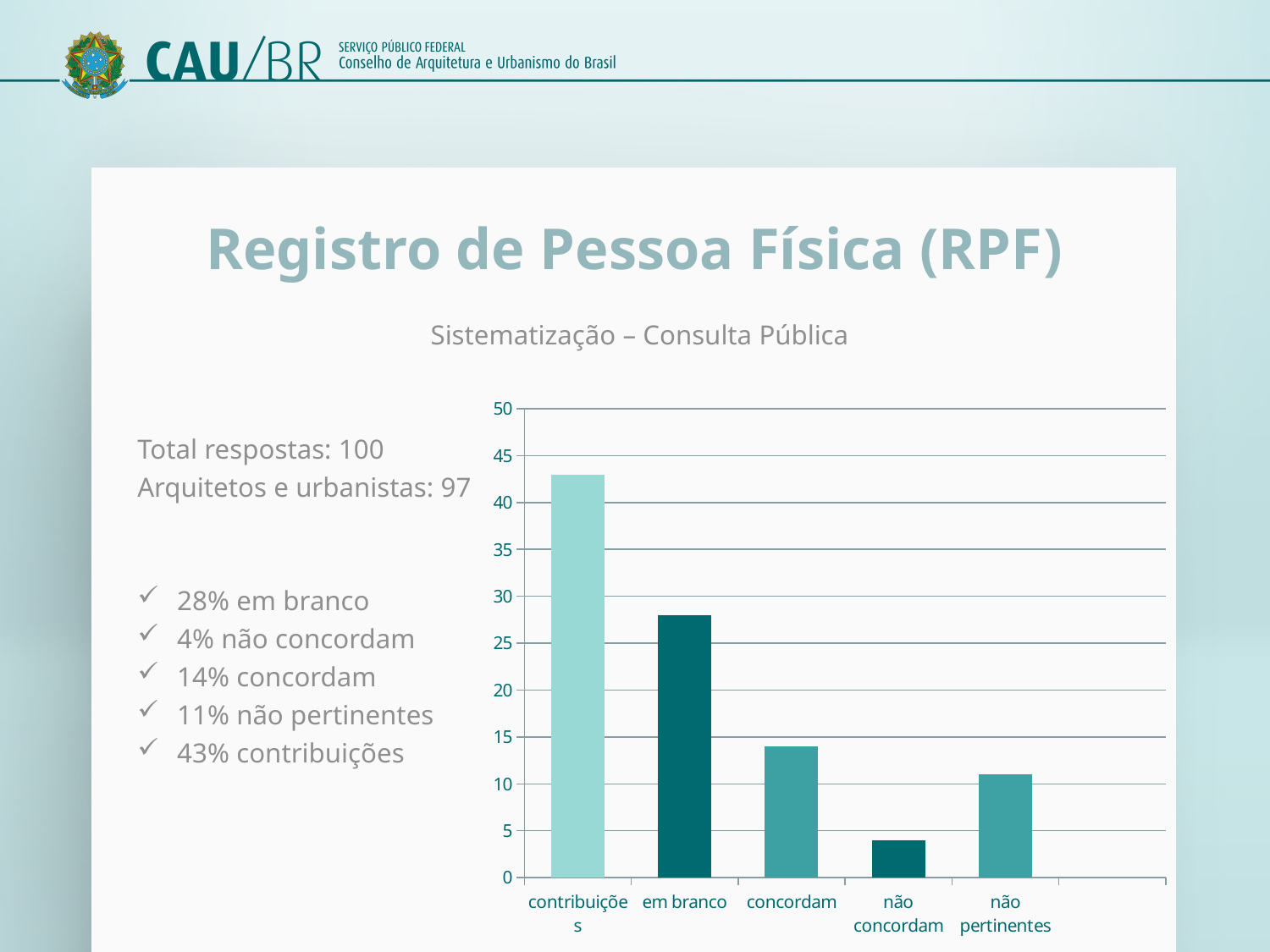
What is the title of the slide containing the chart? Registro de Pessoa Física (RPF) What kind of chart is shown on the slide? bar chart What is the maximum value shown on the chart's vertical axis? 50 Which is larger, the bar for em branco or the bar for concordam? em branco Is the value for não pertinentes greater or less than 10? greater Which category has the highest bar in the chart? contribuições Is the value for contribuições greater or less than 40? greater Which category has the lowest bar in the chart? não concordam Which is larger, the bar for concordam or the bar for não pertinentes? concordam Is the value for em branco greater or less than 30? less How many categories are shown on the x axis of the chart? 5